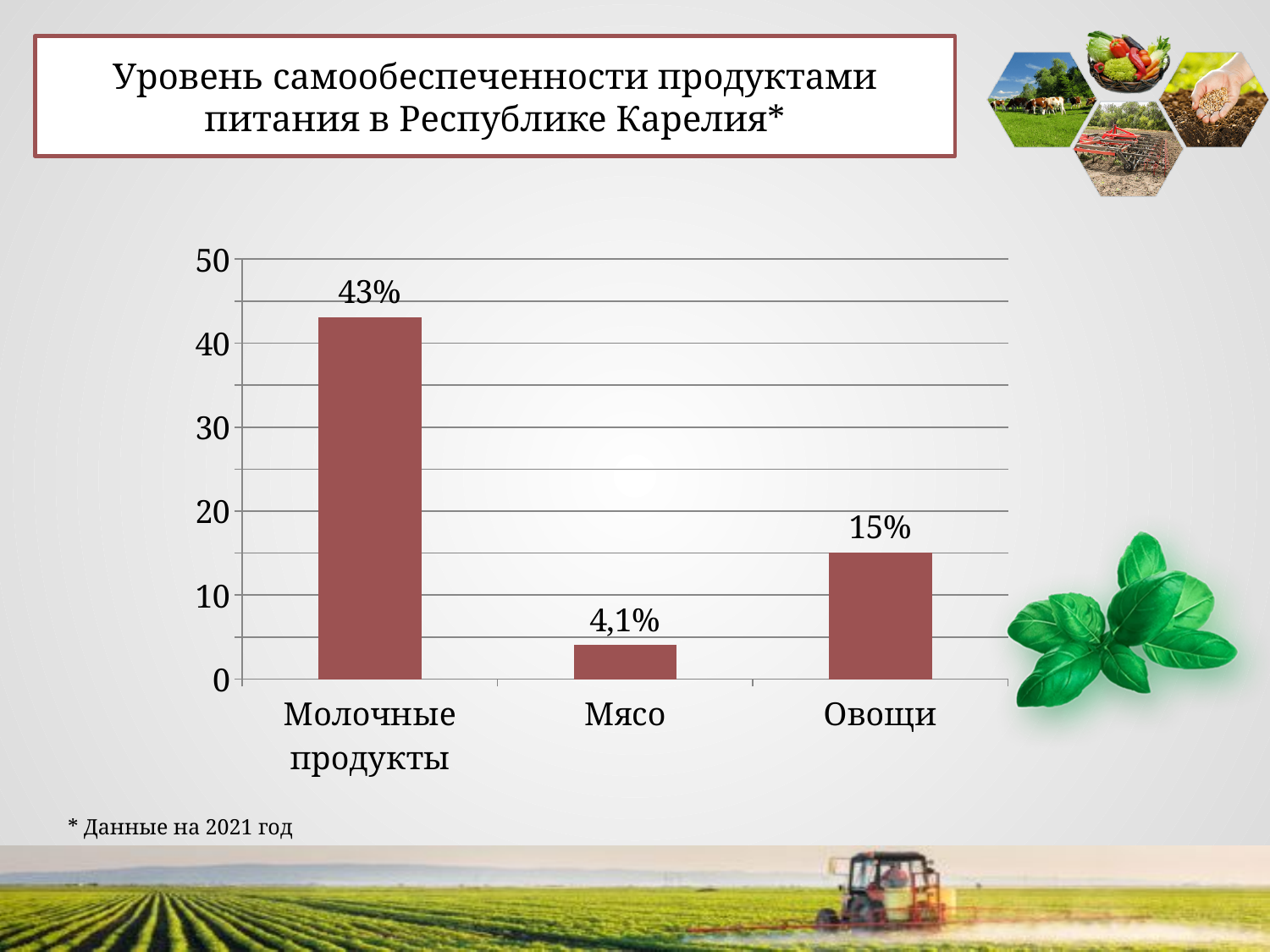
What is the title of the slide? Уровень самообеспеченности продуктами питания в Республике Карелия* What is the difference between the values for Молочные продукты and Овощи? 28% What is the value for Овощи? 15% What kind of chart is shown on the slide? bar chart What is the value for Молочные продукты? 43% Which is larger, the value for Овощи or the value for Мясо? Овощи What year do the data on the chart refer to, according to the footnote? 2021 Which category has the highest value? Молочные продукты What is the value for Мясо? 4,1% Is the value for Молочные продукты greater or less than 40? greater Which category has the lowest value? Мясо How many categories are shown on the chart? 3